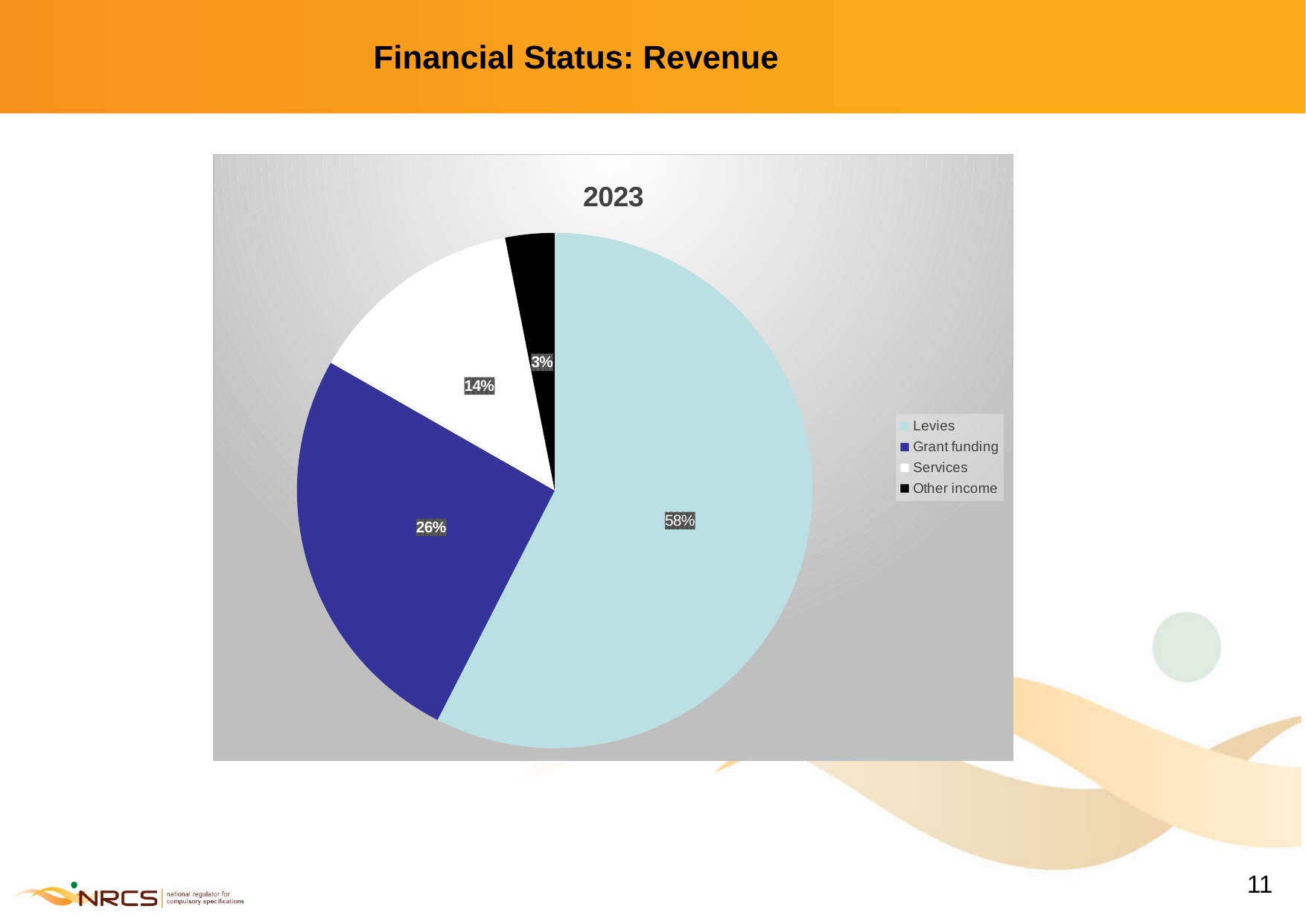
How many slices does the pie chart have? 4 What share of revenue comes from Services? 14% What type of chart is shown on the slide? pie chart What share of revenue comes from Levies? 58% What is the difference in percentage points between Levies and Grant funding? 32 What share of revenue comes from Grant funding? 26% Which revenue source has the largest share? Levies Which is larger, the share for Services or the share for Grant funding? Grant funding What is the title of the chart? 2023 What colour is the Grant funding slice? dark blue Which revenue source has the smallest share? Other income